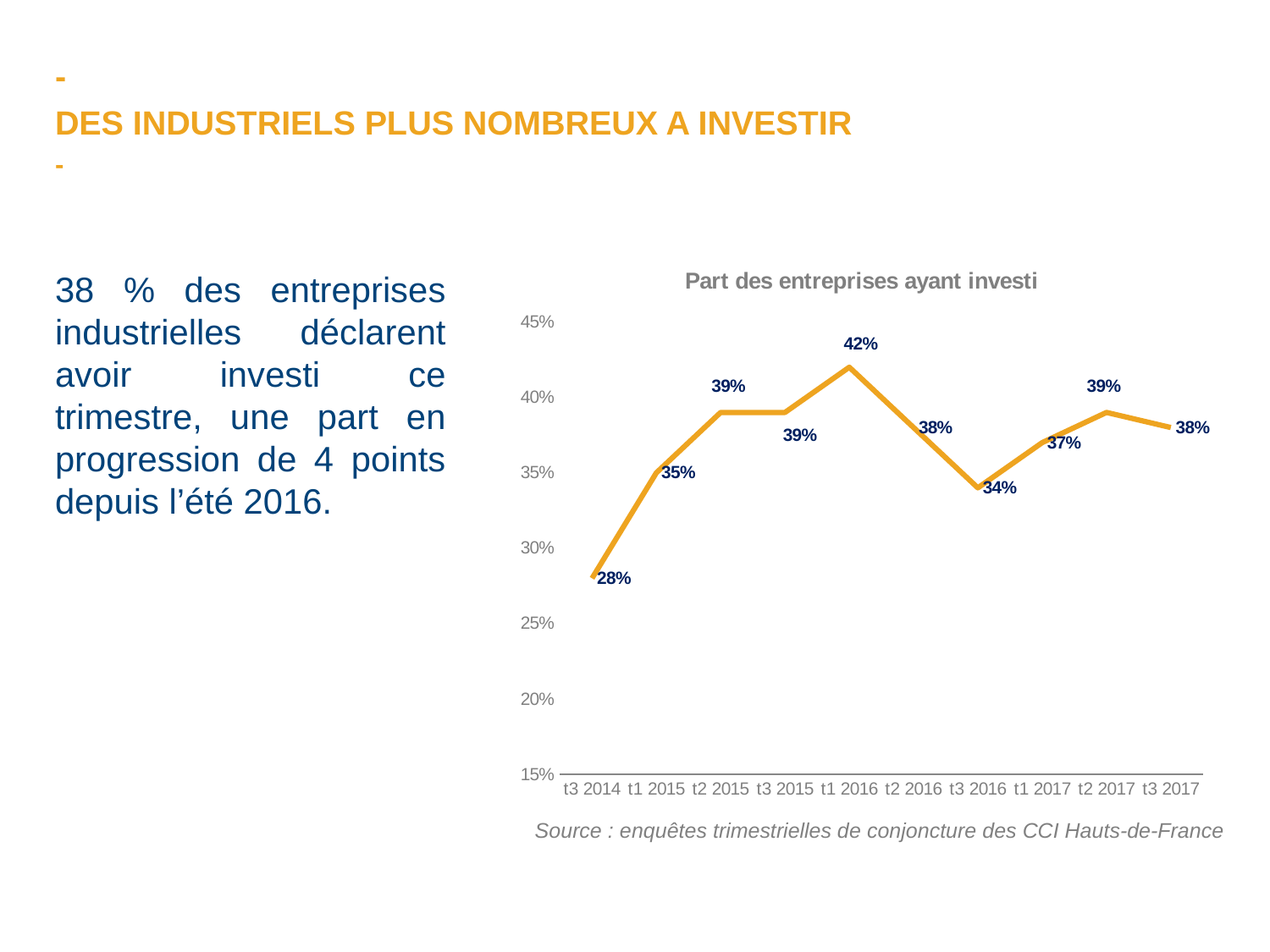
What is the value for t3 2014? 28% What is the title of the chart? Part des entreprises ayant investi What is the difference between the values for t1 2016 and t3 2016? 8 points What is the value for t3 2017? 38% Which quarter has the lowest share of companies having invested? t3 2014 Is the value for t3 2014 greater or less than 30%? less Which is larger, the value for t1 2015 or the value for t1 2017? t1 2017 What is the value for t3 2016? 34% What is the value for t1 2016? 42% What kind of chart is shown on the slide? line chart How many quarters are plotted on the chart? 10 Which quarter has the highest share of companies having invested? t1 2016